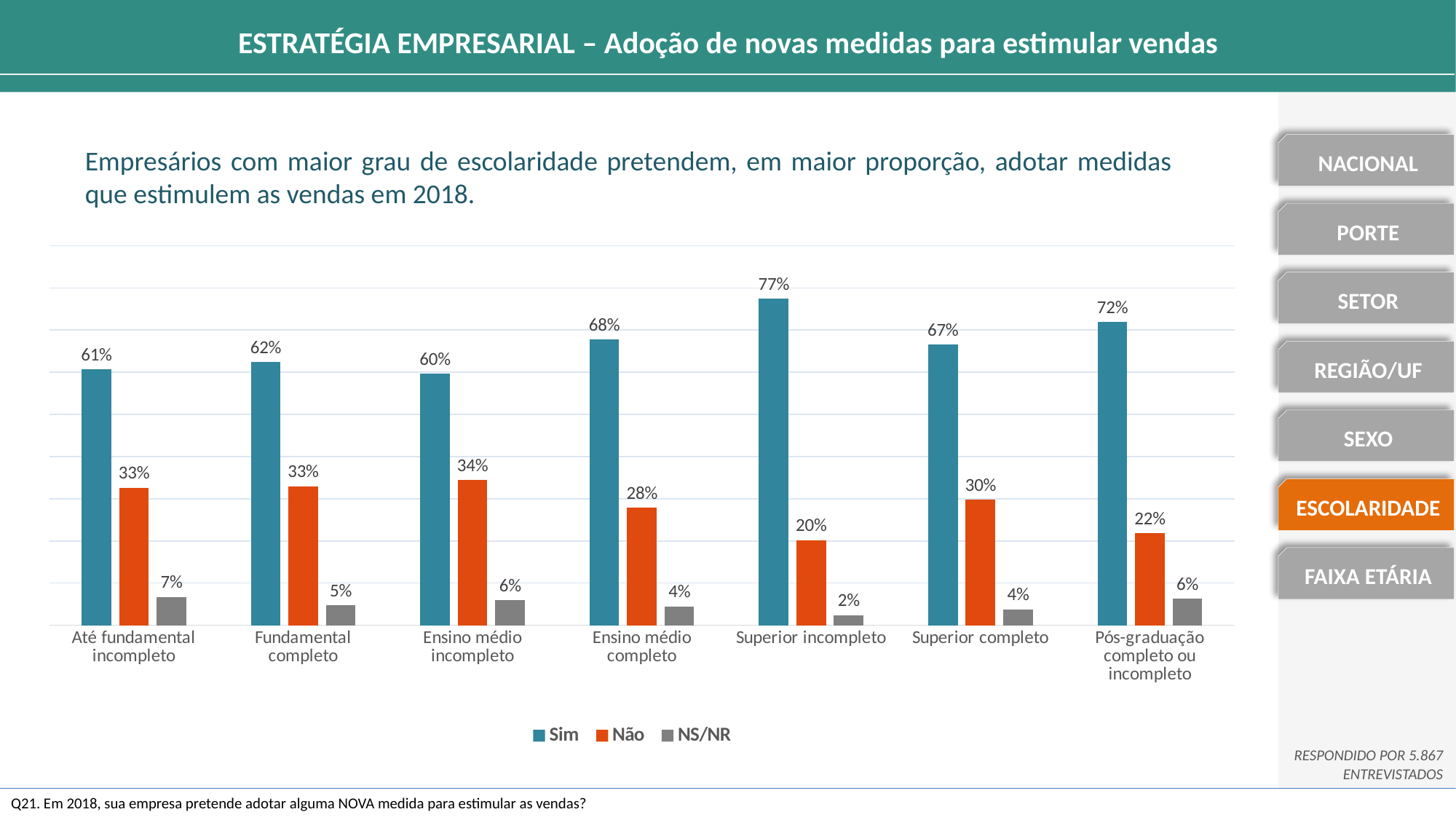
Which category has the highest 'Sim' value? Superior incompleto What is the 'Sim' value for Superior incompleto? 77% Which is larger: the 'Não' value for Superior completo or for Pós-graduação completo ou incompleto? Superior completo What is the 'Não' value for Ensino médio completo? 28% What is the 'NS/NR' value for Até fundamental incompleto? 7% Which category has the lowest 'NS/NR' value? Superior incompleto How many education categories are shown on the x axis? 7 What is the 'Sim' value for Pós-graduação completo ou incompleto? 72% How many series does the legend list? 3 What kind of chart is shown on the slide? Bar chart Which series is shown in orange in the legend? Não What is the difference between the 'Sim' values for Superior incompleto and Ensino médio incompleto? 17%